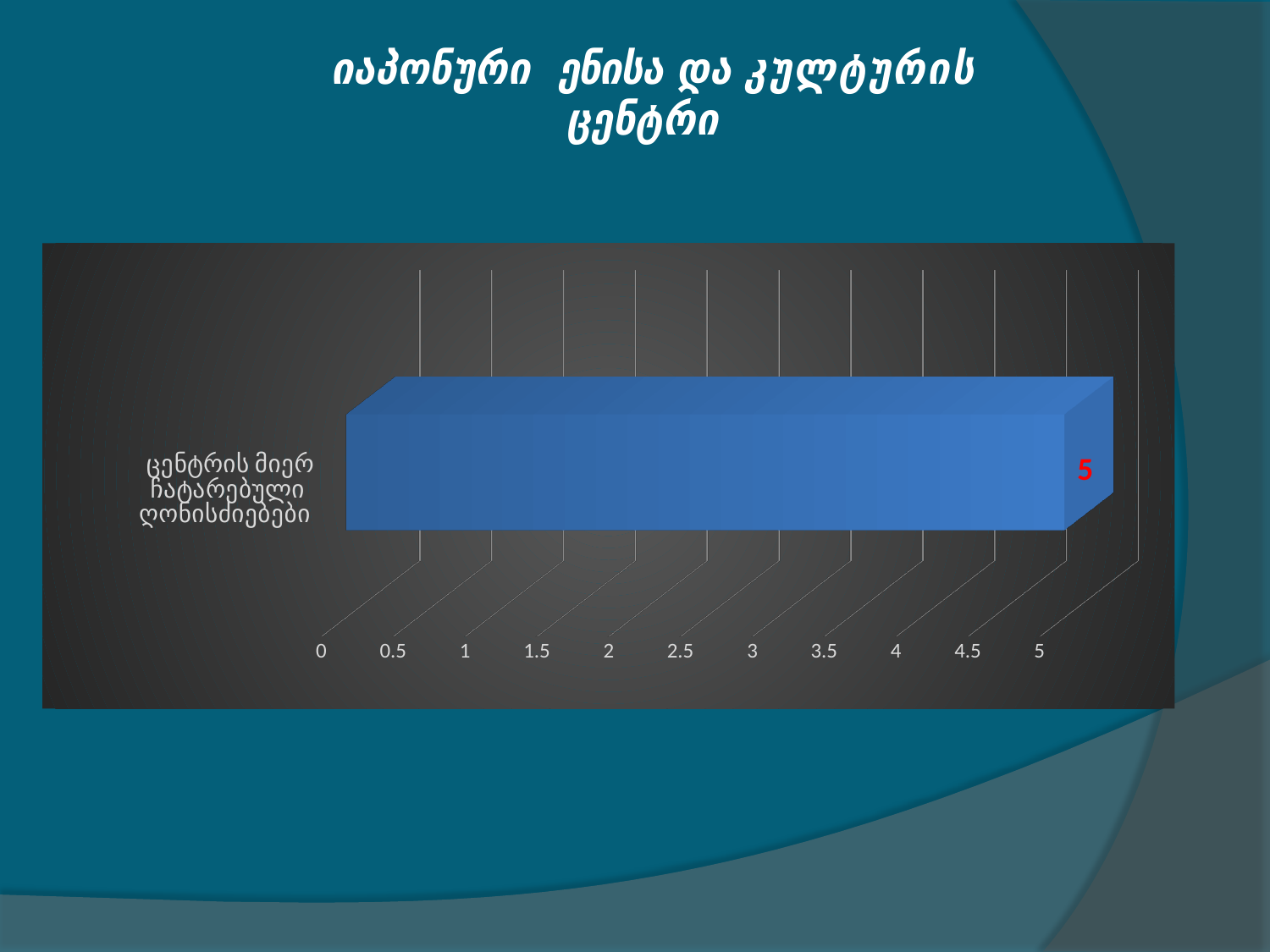
Is the value for ცენტრის მიერ ჩატარებული ღონისძიებები greater or less than 3? greater How many categories does the chart show? 1 What is the maximum value shown on the chart's value axis? 5 What is the value for ცენტრის მიერ ჩატარებული ღონისძიებები? 5 Are the bars in the chart horizontal or vertical? horizontal Which category has the highest value on the chart? ცენტრის მიერ ჩატარებული ღონისძიებები What is the title of the slide containing the chart? იაპონური ენისა და კულტურის ცენტრი What kind of chart is shown on the slide? bar chart Is the value for ცენტრის მიერ ჩატარებული ღონისძიებები greater or less than 4.5? greater